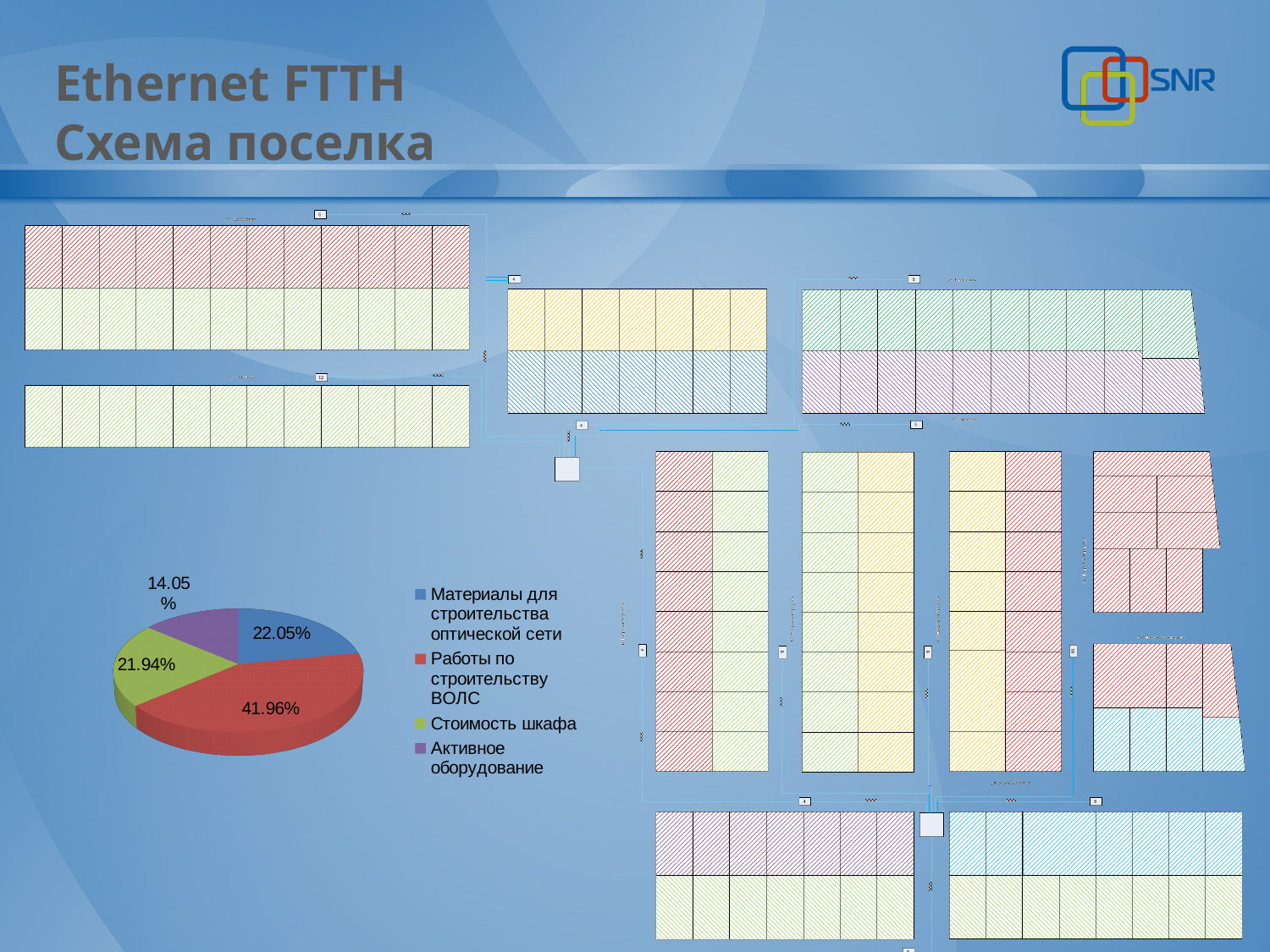
What share of the pie does "Работы по строительству ВОЛС" have? 41.96% What colour is the slice for "Стоимость шкафа" in the pie chart? green What share of the pie does "Активное оборудование" have? 14.05% Which is larger: the share of "Работы по строительству ВОЛС" or the share of "Стоимость шкафа"? Работы по строительству ВОЛС What share of the pie does "Материалы для строительства оптической сети" have? 22.05% What is the difference between the shares of "Работы по строительству ВОЛС" and "Активное оборудование"? 27.91% How many entries does the legend of the pie chart list? 4 Which category has the smallest slice of the pie? Активное оборудование What kind of chart is shown on the slide? pie chart Which category has the largest slice of the pie? Работы по строительству ВОЛС How many slices does the pie chart have? 4